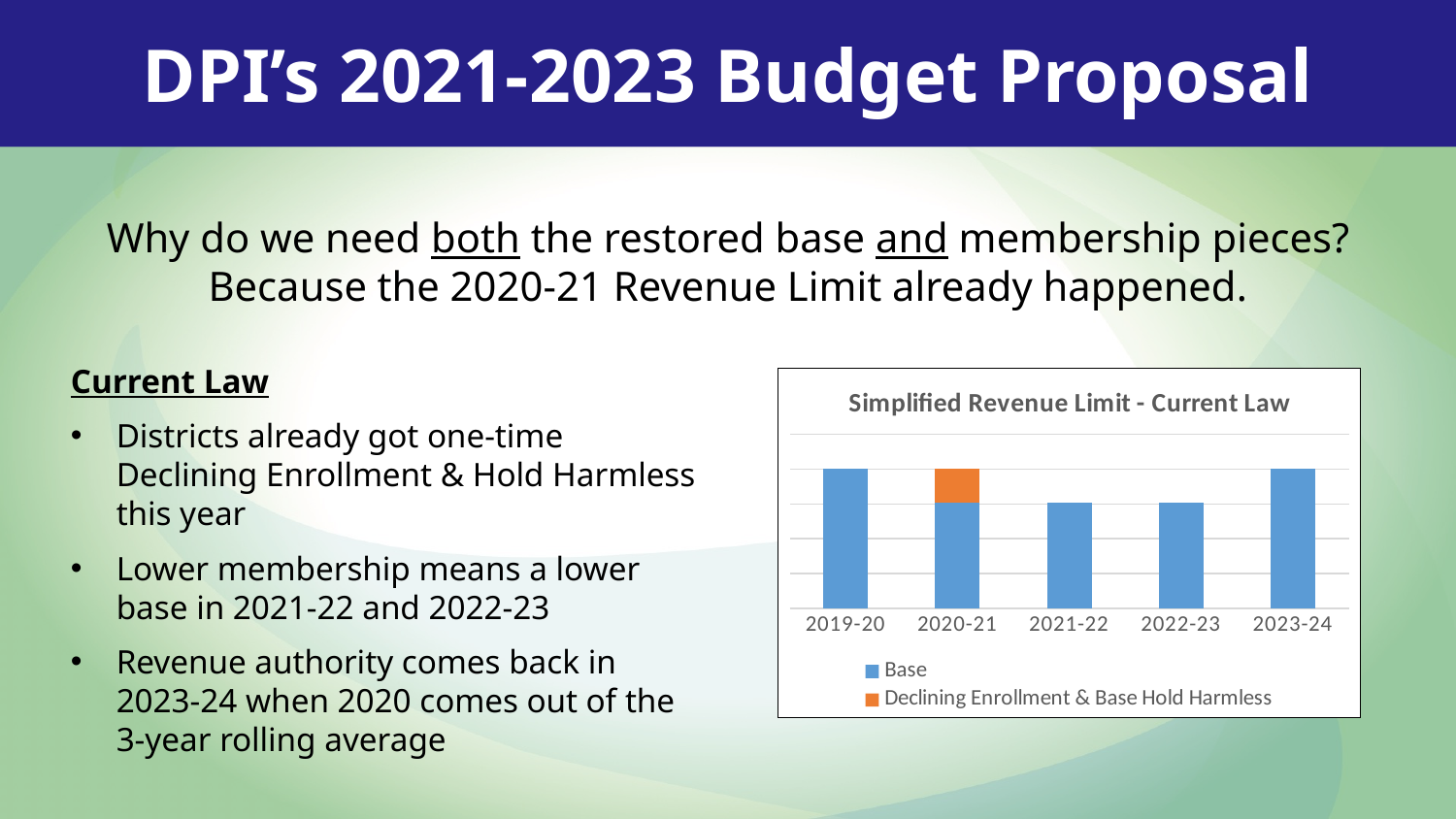
What kind of chart is shown on the slide? Bar chart Does the Base value rise or fall from 2022-23 to 2023-24? Rise How many years are shown on the x axis of the chart? 5 What is the first year shown on the x axis of the chart? 2019-20 What is the title of the chart? Simplified Revenue Limit - Current Law Is the Base value larger in 2023-24 or in 2022-23? 2023-24 Is the Base value larger in 2019-20 or in 2021-22? 2019-20 Does the Base value rise or fall from 2019-20 to 2021-22? Fall Which year is the only one with a Declining Enrollment & Base Hold Harmless segment? 2020-21 What colour represents the Base series in the chart? Blue How many series does the chart's legend list? 2 Is the Base value larger in 2019-20 or in 2020-21? 2019-20